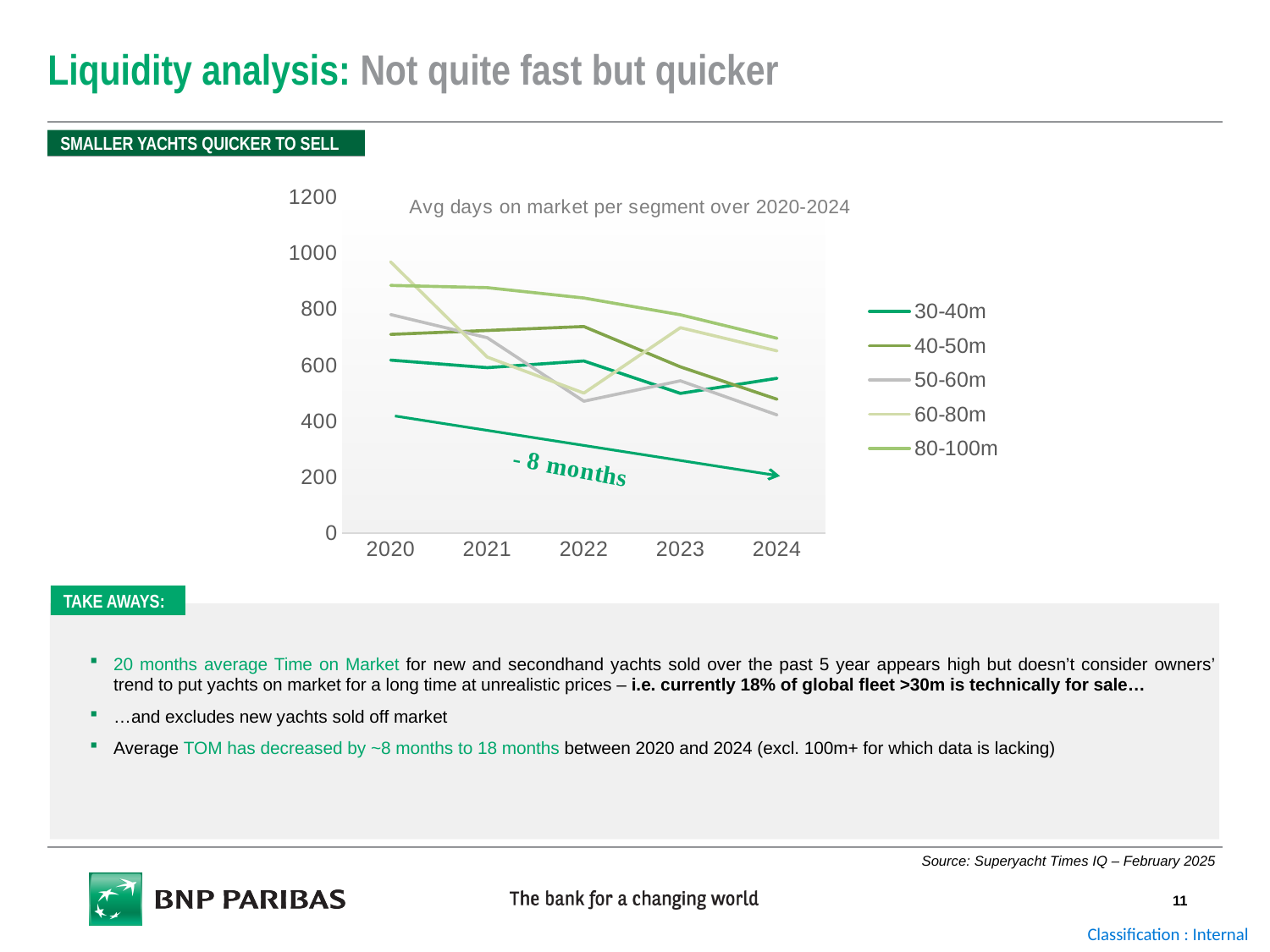
Is the value for the 30-40m segment in 2020 greater or less than 800? less Does the 80-100m line rise or fall from 2020 to 2024? fall How many series does the chart legend list? 5 Is the value for the 80-100m segment in 2024 greater or less than 600? greater How many years are shown on the x axis of the chart? 5 What kind of chart is shown on the slide? line chart In 2020, which segment has the larger value: 80-100m or 30-40m? 80-100m Is the value for the 60-80m segment in 2020 greater or less than 800? greater Which segment has the highest average days on market in 2020? 60-80m What is the title of the chart? Avg days on market per segment over 2020-2024 What annotation is written along the arrow inside the chart? - 8 months